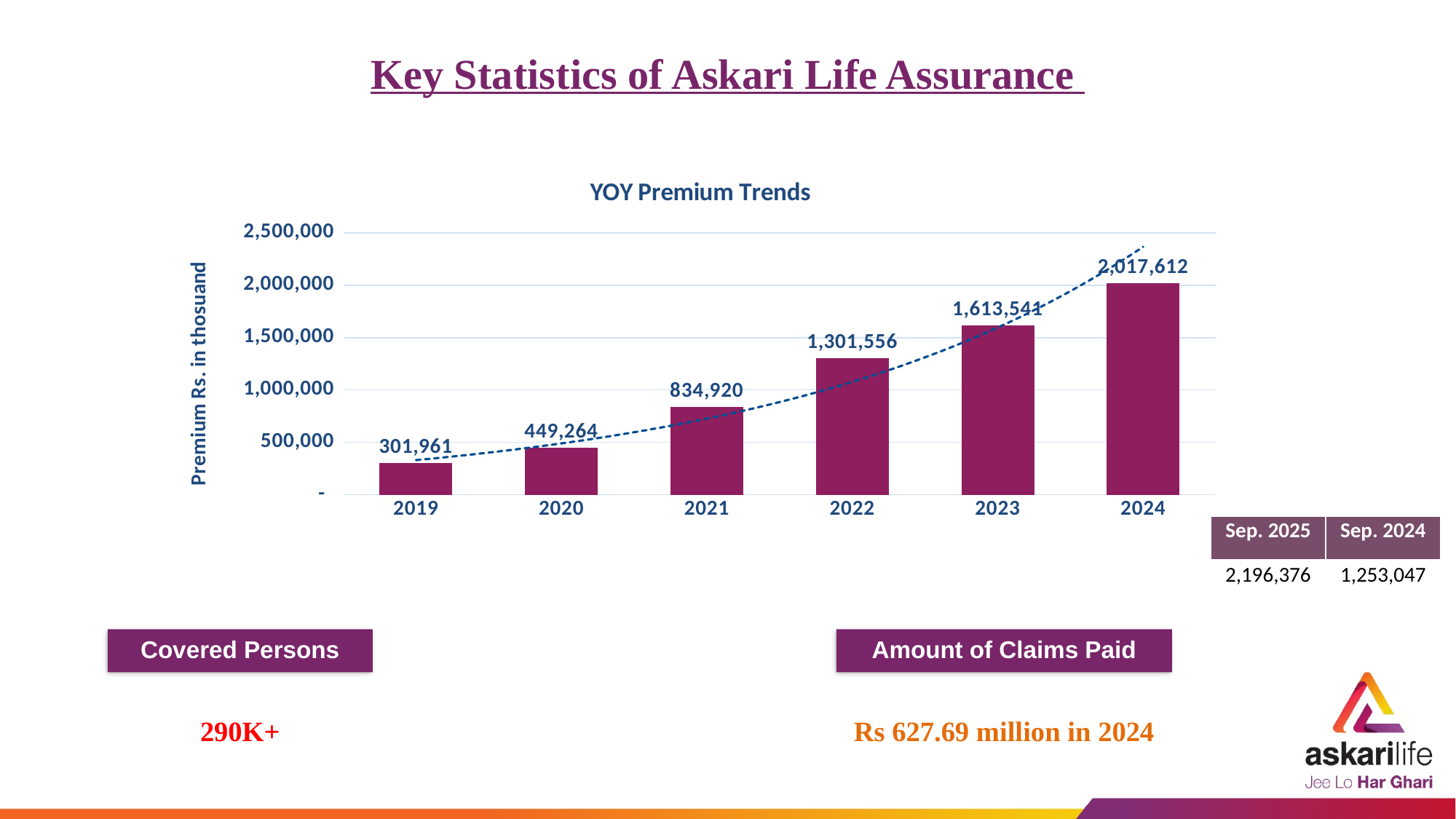
What kind of chart is the YOY Premium Trends chart? Bar chart What is the difference between the 2024 and 2023 premium values in the YOY Premium Trends chart? 404,071 Is the premium value for 2024 in the YOY Premium Trends chart greater or less than 2,000,000? greater Which year has the highest premium in the YOY Premium Trends chart? 2024 What is the premium value for 2023 in the YOY Premium Trends chart? 1,613,541 How many years are shown on the x axis of the YOY Premium Trends chart? 6 What is the difference between the 2020 and 2019 premium values in the YOY Premium Trends chart? 147,303 In the YOY Premium Trends chart, which year has the larger premium, 2021 or 2022? 2022 Do the premium values in the YOY Premium Trends chart rise or fall from 2019 to 2024? Rise What is the premium value for 2021 in the YOY Premium Trends chart? 834,920 What is the premium value for 2019 in the YOY Premium Trends chart? 301,961 Which year has the lowest premium in the YOY Premium Trends chart? 2019